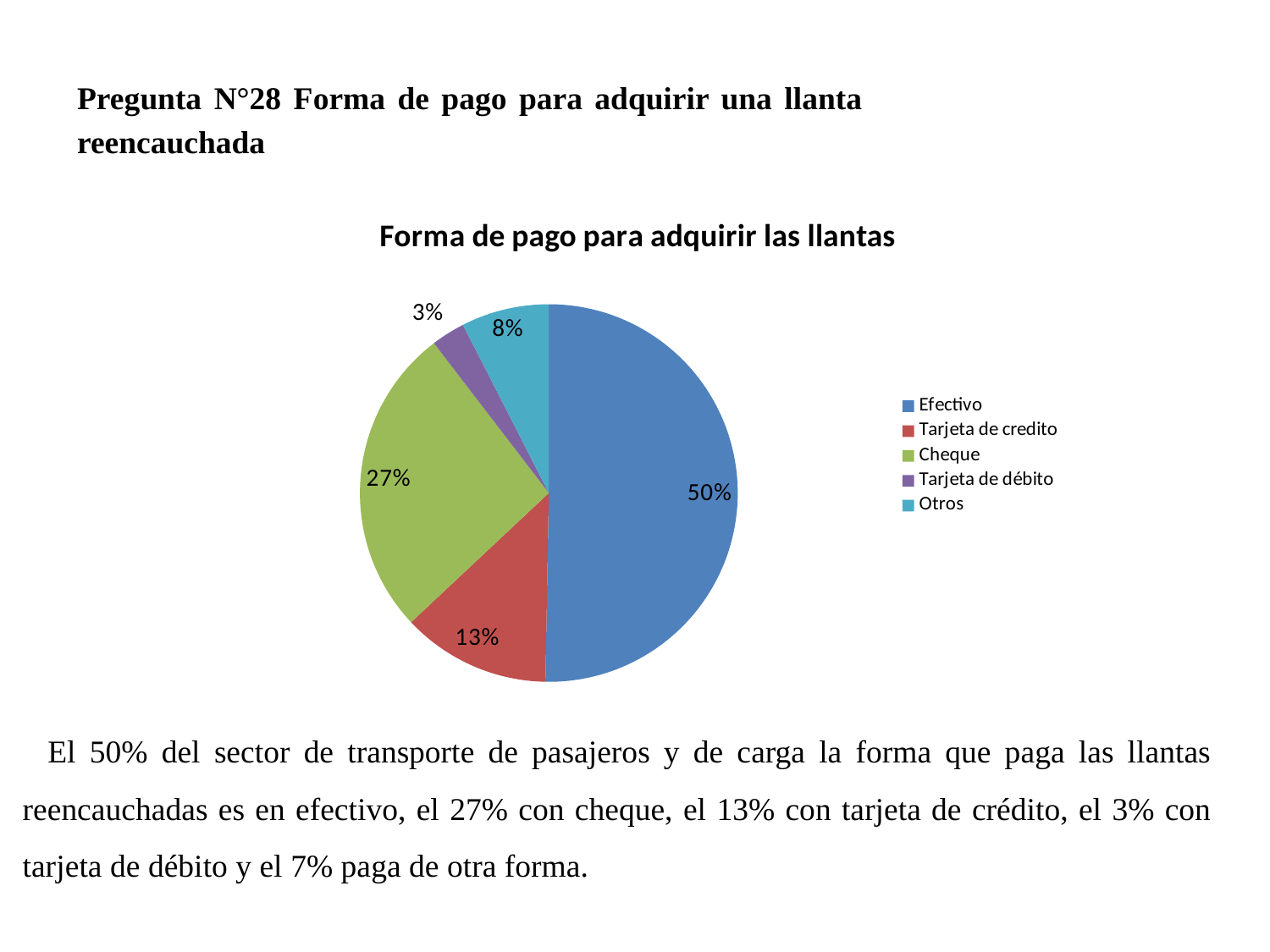
What is the title of the chart? Forma de pago para adquirir las llantas What share of the pie does Tarjeta de credito represent? 13% What type of chart is shown on the slide? Pie chart What share of the pie does Cheque represent? 27% What share of the pie does Otros represent? 8% Which is larger, the share for Tarjeta de credito or the share for Otros? Tarjeta de credito What share of the pie does Tarjeta de débito represent? 3% Which payment method has the smallest slice of the pie? Tarjeta de débito Which payment method has the largest slice of the pie? Efectivo How many categories does the legend list? 5 What is the difference in percentage points between Efectivo and Cheque? 23% What share of the pie does Efectivo represent? 50%